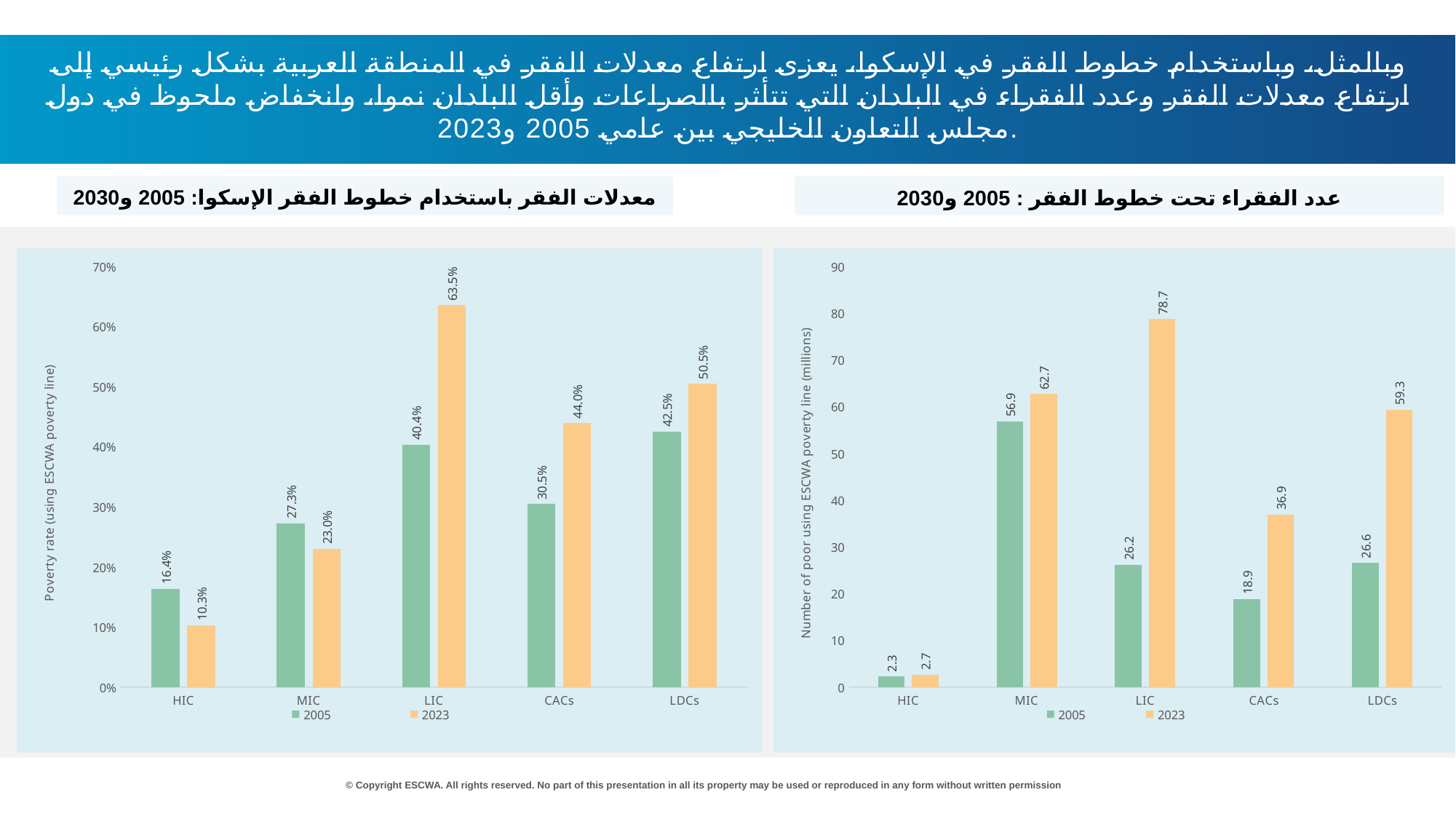
In the right chart (number of poor), what is the 2005 value for CACs? 18.9 In the right chart (number of poor), which category has the lowest 2005 value? HIC How many series does the legend of the left chart (poverty rate) list? 2 What type of chart is the right chart (number of poor)? Bar chart In the right chart (number of poor), what is the difference between the 2023 and 2005 values for MIC? 5.8 How many categories are shown on the x axis of the right chart (number of poor)? 5 In the left chart (poverty rate), what is the difference between the 2023 and 2005 values for CACs? 13.5% In the left chart (poverty rate), which category has the highest 2023 value? LIC In the left chart (poverty rate), what is the 2023 value for LIC? 63.5% In the left chart (poverty rate), what is the 2005 value for HIC? 16.4% In the left chart (poverty rate), which is larger for MIC: the 2005 value or the 2023 value? 2005 In the right chart (number of poor), what is the 2023 value for LIC? 78.7